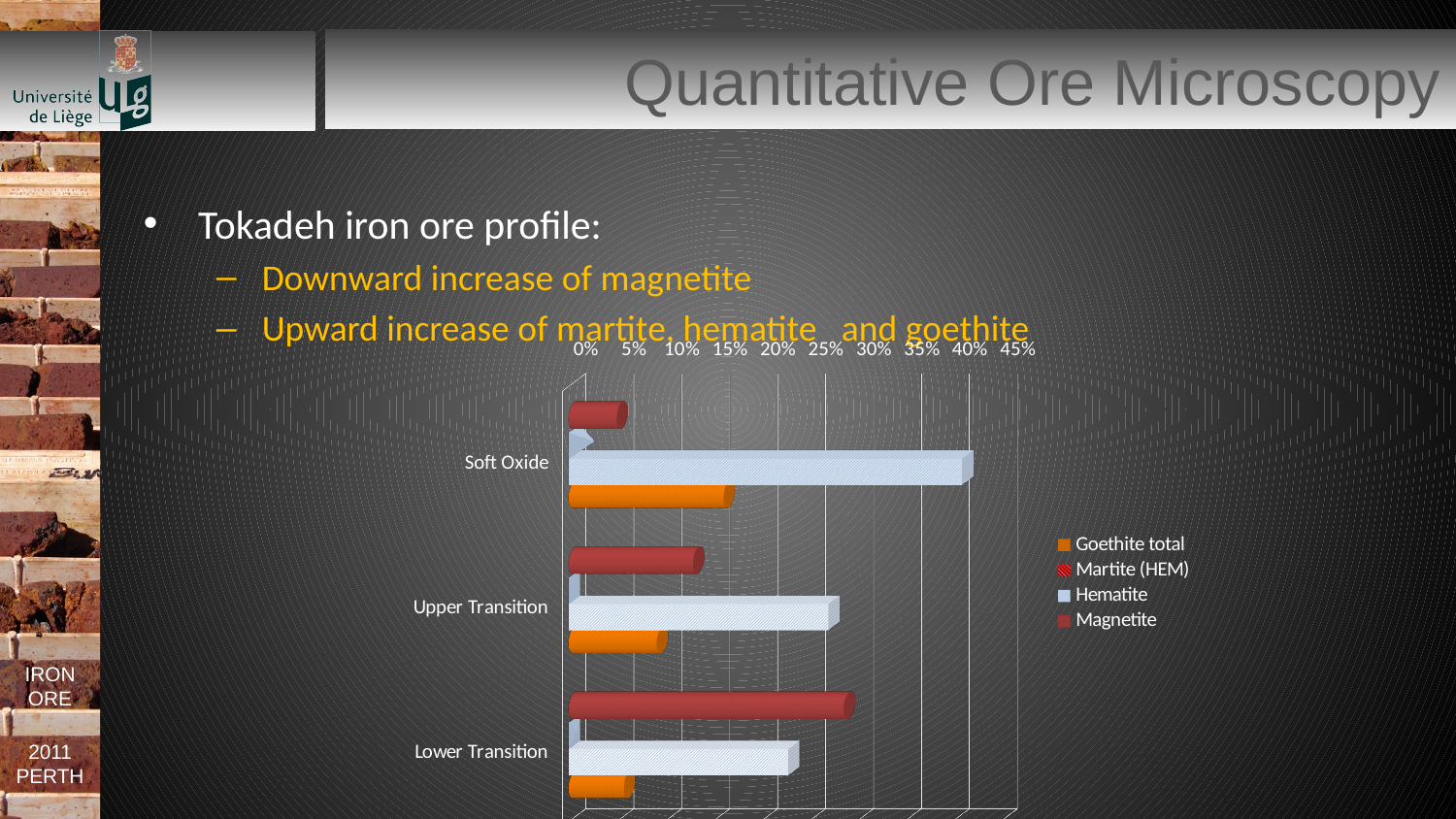
How many series does the chart legend list? 4 For Lower Transition, which is larger: Magnetite or Goethite total? Magnetite Is the Hematite value for Soft Oxide greater or less than 35%? less Is the Magnetite value for Lower Transition greater or less than 20%? greater Which category has the lowest Magnetite value? Soft Oxide Is the Magnetite value for Soft Oxide greater or less than 10%? less Which category has the highest Goethite total value? Soft Oxide What kind of chart is shown on the slide? bar chart How many ore zone categories are plotted on the chart? 3 For Soft Oxide, which is larger: Hematite or Goethite total? Goethite total Which category has the highest Hematite value? Soft Oxide Which category has the highest Magnetite value? Lower Transition